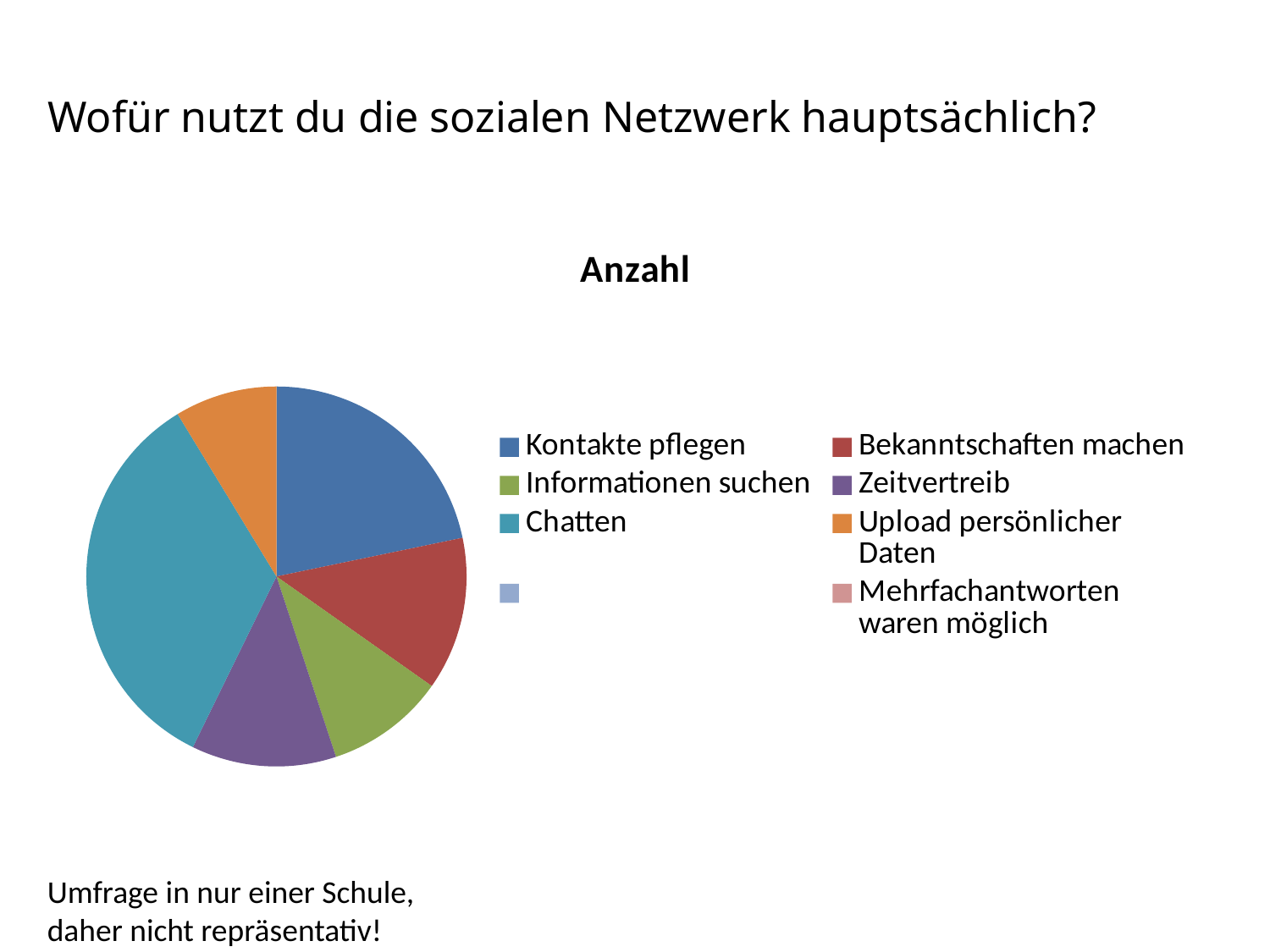
What kind of chart is shown on the slide? pie chart What colour is the slice for Chatten? teal How many slices does the pie chart have? 6 Which category has the largest slice of the pie? Chatten Which slice is larger, Chatten or Zeitvertreib? Chatten Which slice is larger, Kontakte pflegen or Bekanntschaften machen? Kontakte pflegen What is the title of the chart? Anzahl Which slice is larger, Chatten or Kontakte pflegen? Chatten